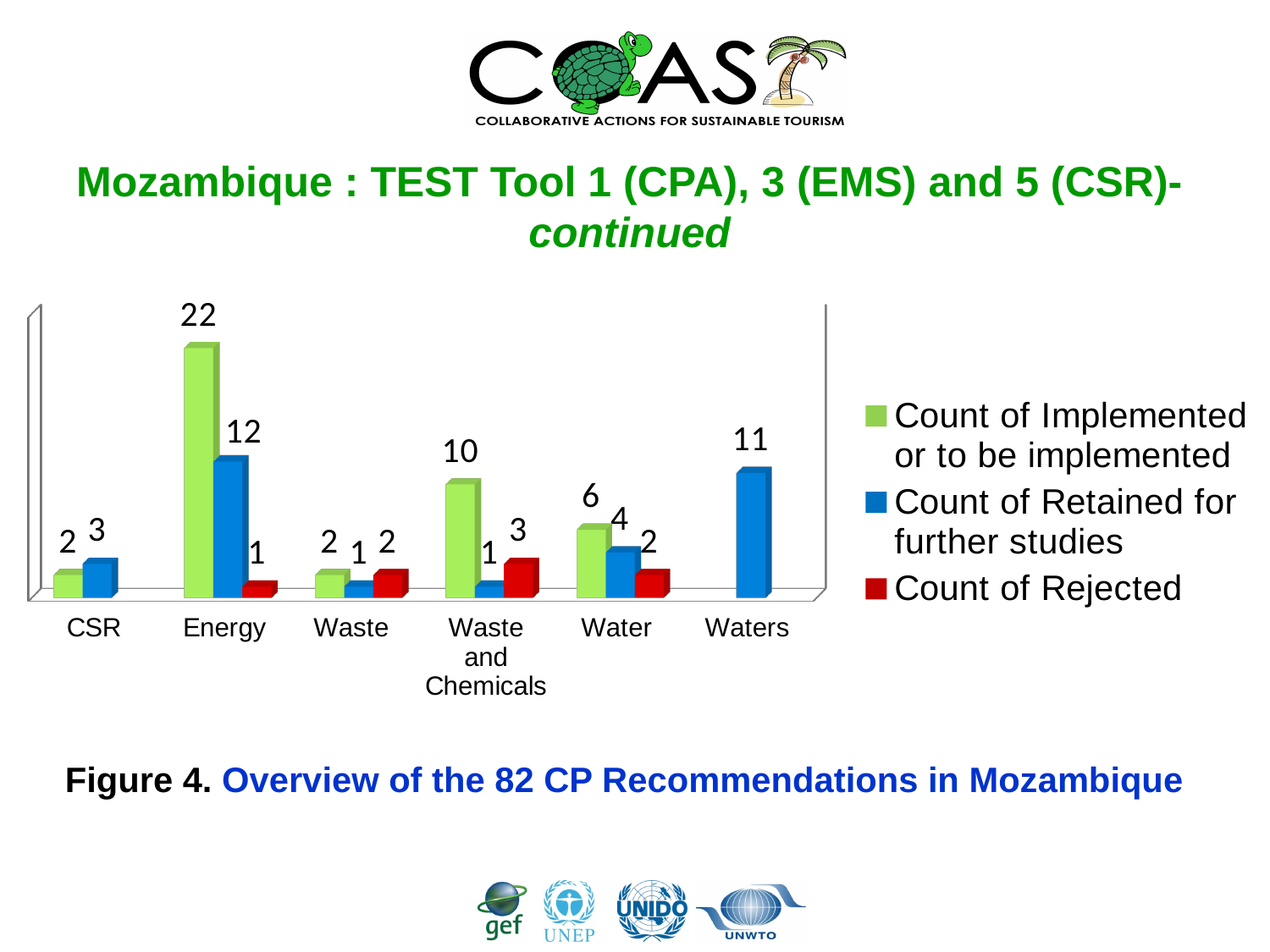
What is the Count of Retained for further studies for Waters? 11 What is the difference between the Count of Implemented or to be implemented and the Count of Retained for further studies for Energy? 10 What is the Count of Implemented or to be implemented for Energy? 22 What kind of chart is shown on the slide? Bar chart What is the Count of Retained for further studies for Water? 4 Which is larger for Water: the Count of Implemented or to be implemented or the Count of Retained for further studies? Count of Implemented or to be implemented How many categories are shown on the x axis? 6 What is the Count of Rejected for Waste and Chemicals? 3 Which category has the highest Count of Implemented or to be implemented? Energy Which colour represents the Count of Rejected series in the legend? Red How many series does the legend list? 3 Which category has the highest Count of Rejected? Waste and Chemicals